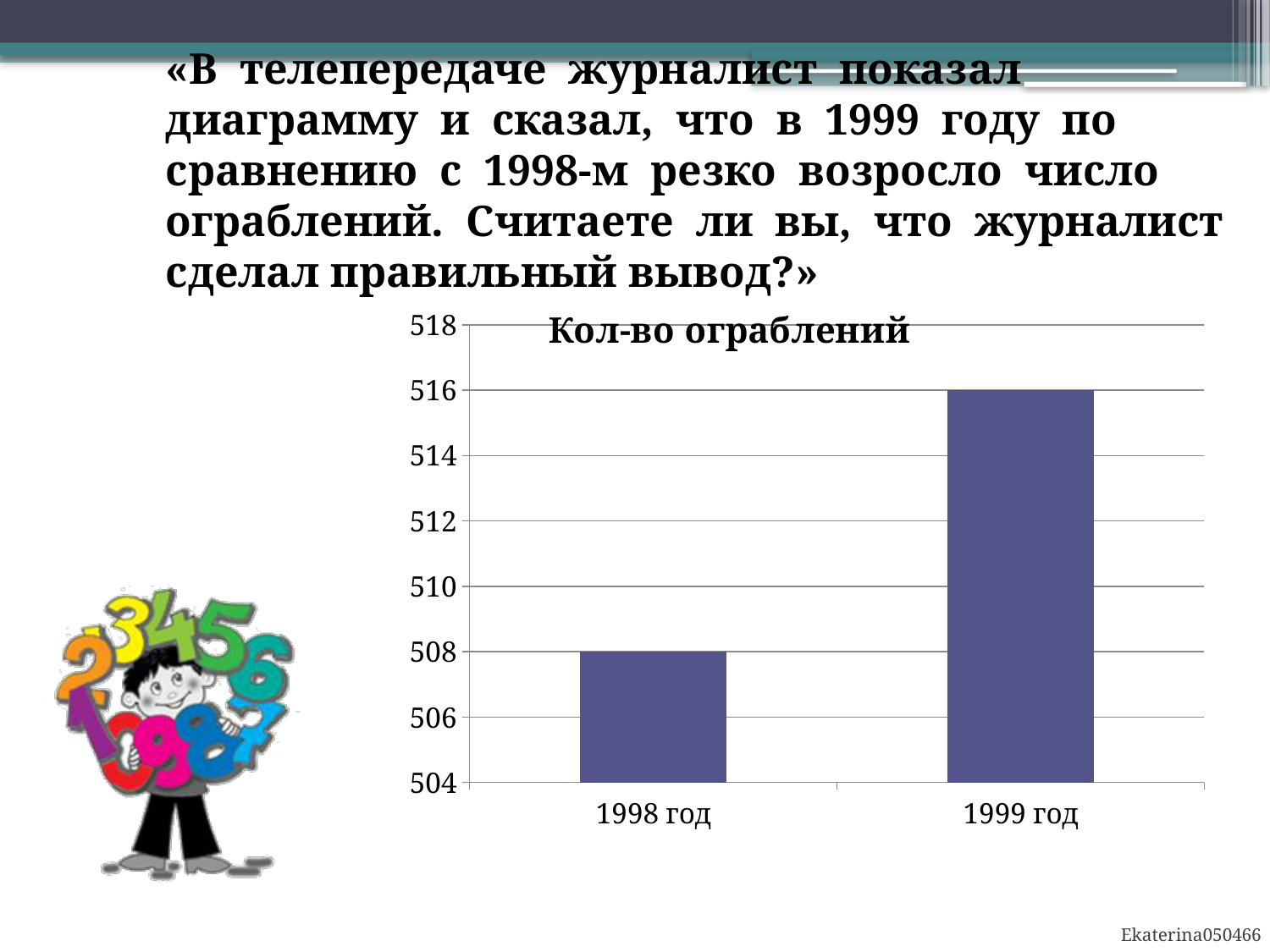
What is the lowest value shown on the vertical axis of the chart? 504 What is the title of the chart? Кол-во ограблений What is the value for 1998 год? 508 Is the value for 1999 год greater or less than 514? greater Do the values rise or fall from 1998 год to 1999 год? rise Which year has the higher value? 1999 год What is the value for 1999 год? 516 Which year has the lower value? 1998 год What kind of chart is shown on the slide? bar chart How many categories are plotted on the x axis of the chart? 2 Is the value for 1998 год greater or less than 510? less What is the difference between the values for 1999 год and 1998 год? 8